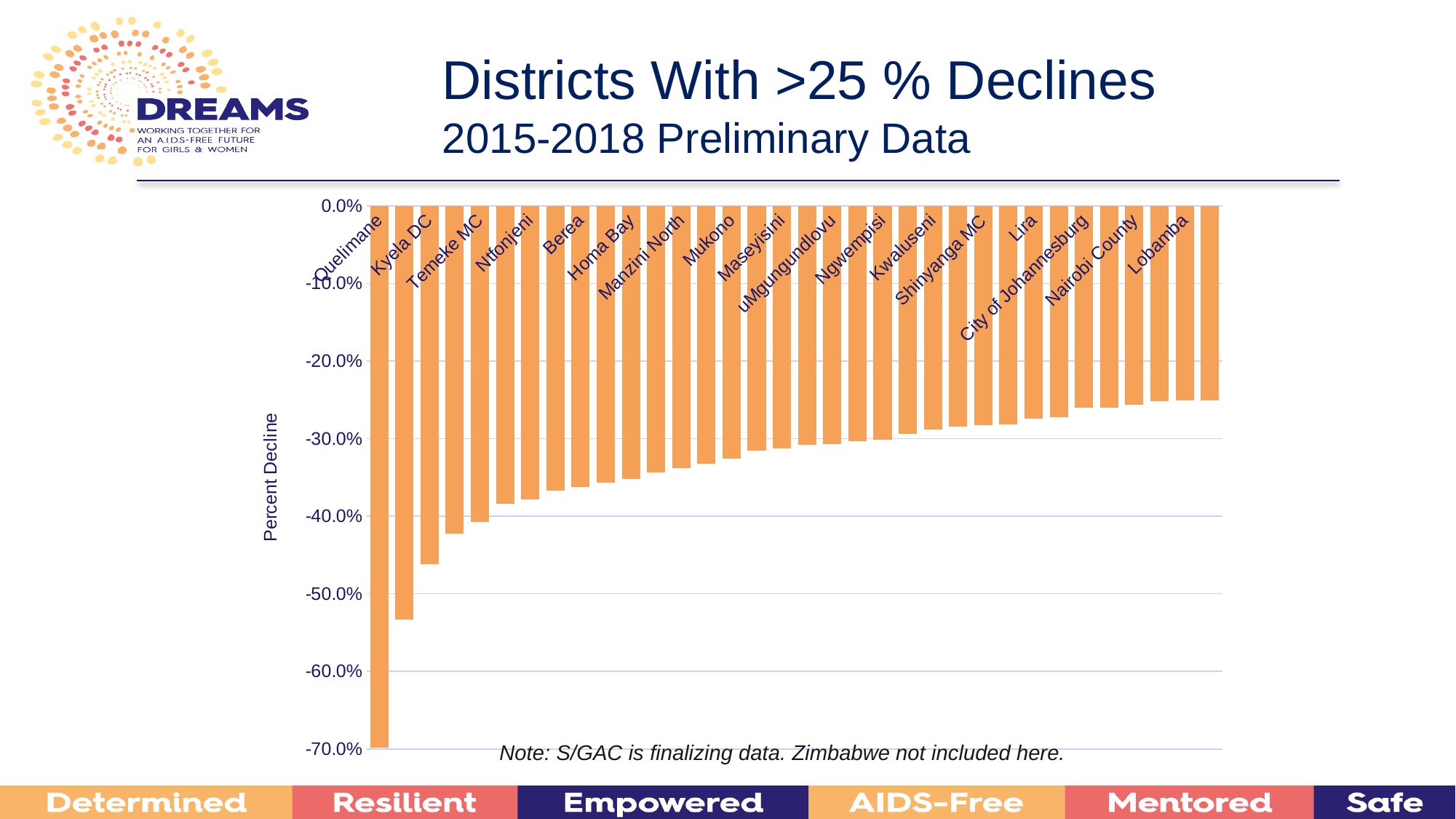
Is the value for Lobamba greater or less than -30.0%? greater Do the bar values rise or fall (become less negative or more negative) moving from left to right along the x axis? rise What is the label on the vertical axis of the chart? Percent Decline Which district shows a larger decline, Temeke MC or Lira? Temeke MC Which district shows a larger decline, Quelimane or Kyela DC? Quelimane Is the value for Kyela DC greater or less than -50.0%? greater Is the value for Berea greater or less than -30.0%? less Which labeled district has the largest percent decline (the lowest bar)? Quelimane What kind of chart is shown on the slide? bar chart